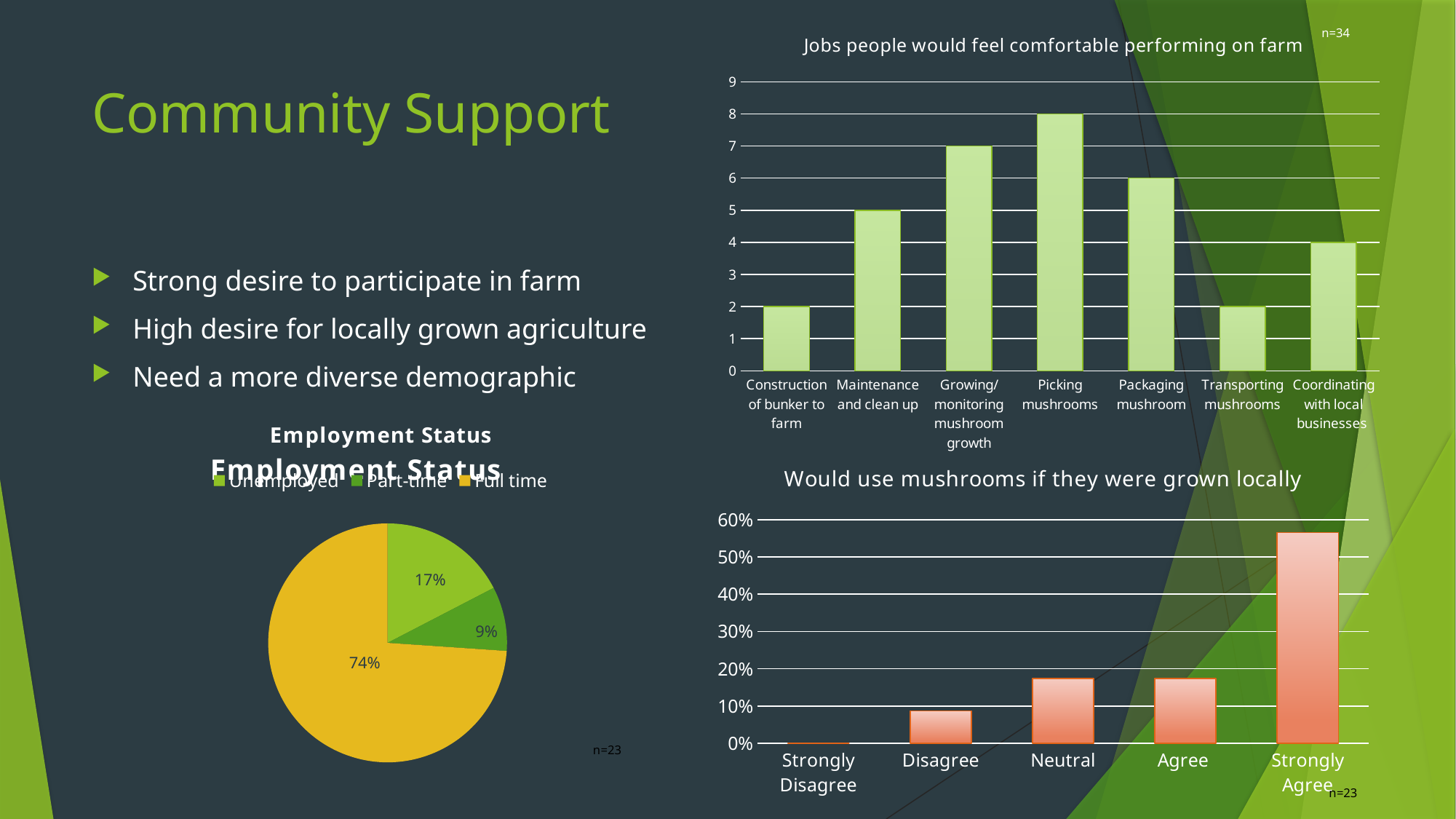
In the 'Jobs people would feel comfortable performing on farm' chart, which job has the highest value? Picking mushrooms In the 'Jobs people would feel comfortable performing on farm' chart, which is larger: Packaging mushroom or Transporting mushrooms? Packaging mushroom In the 'Would use mushrooms if they were grown locally' chart, is the value for Disagree greater or less than 10%? less In the 'Jobs people would feel comfortable performing on farm' chart, what is the value for Maintenance and clean up? 5 What kind of chart is 'Would use mushrooms if they were grown locally'? bar chart In the 'Employment Status' pie chart, what share is Full time? 74% In the 'Would use mushrooms if they were grown locally' chart, is the value for Strongly Agree greater or less than 50%? greater How many job categories are shown in the 'Jobs people would feel comfortable performing on farm' chart? 7 In the 'Jobs people would feel comfortable performing on farm' chart, what is the difference between Growing/monitoring mushroom growth and Coordinating with local businesses? 3 How many entries does the legend of the 'Employment Status' pie chart list? 3 In the 'Employment Status' pie chart, what percentage is Part-time? 9% In the 'Jobs people would feel comfortable performing on farm' chart, what is the value for Picking mushrooms? 8